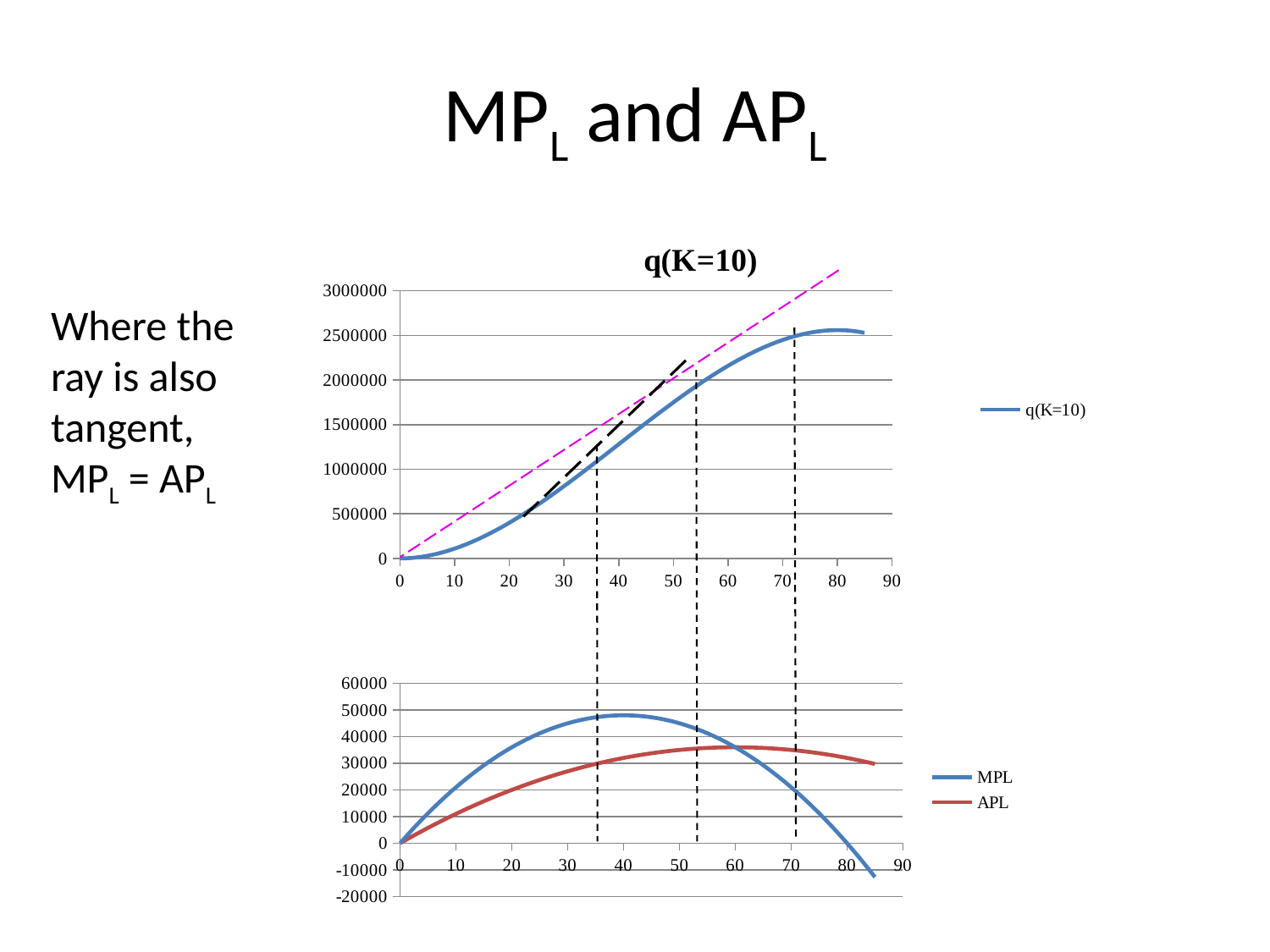
What kind of chart is the top chart titled q(K=10)? line chart What are the two series named in the legend of the bottom chart? MPL and APL What is the title of the top chart? q(K=10) In the top chart q(K=10), is the value at x = 40 greater or less than 1000000? greater In the bottom chart, which series has the larger value at x = 70, MPL or APL? APL In the top chart q(K=10), is the value at x = 20 greater or less than 500000? less In the bottom chart, is the APL value at x = 10 greater or less than 20000? less In the bottom chart, does the MPL series rise or fall between x = 50 and x = 80? fall How many series does the legend of the bottom chart list? 2 In the bottom chart, which series has the larger value at x = 20, MPL or APL? MPL